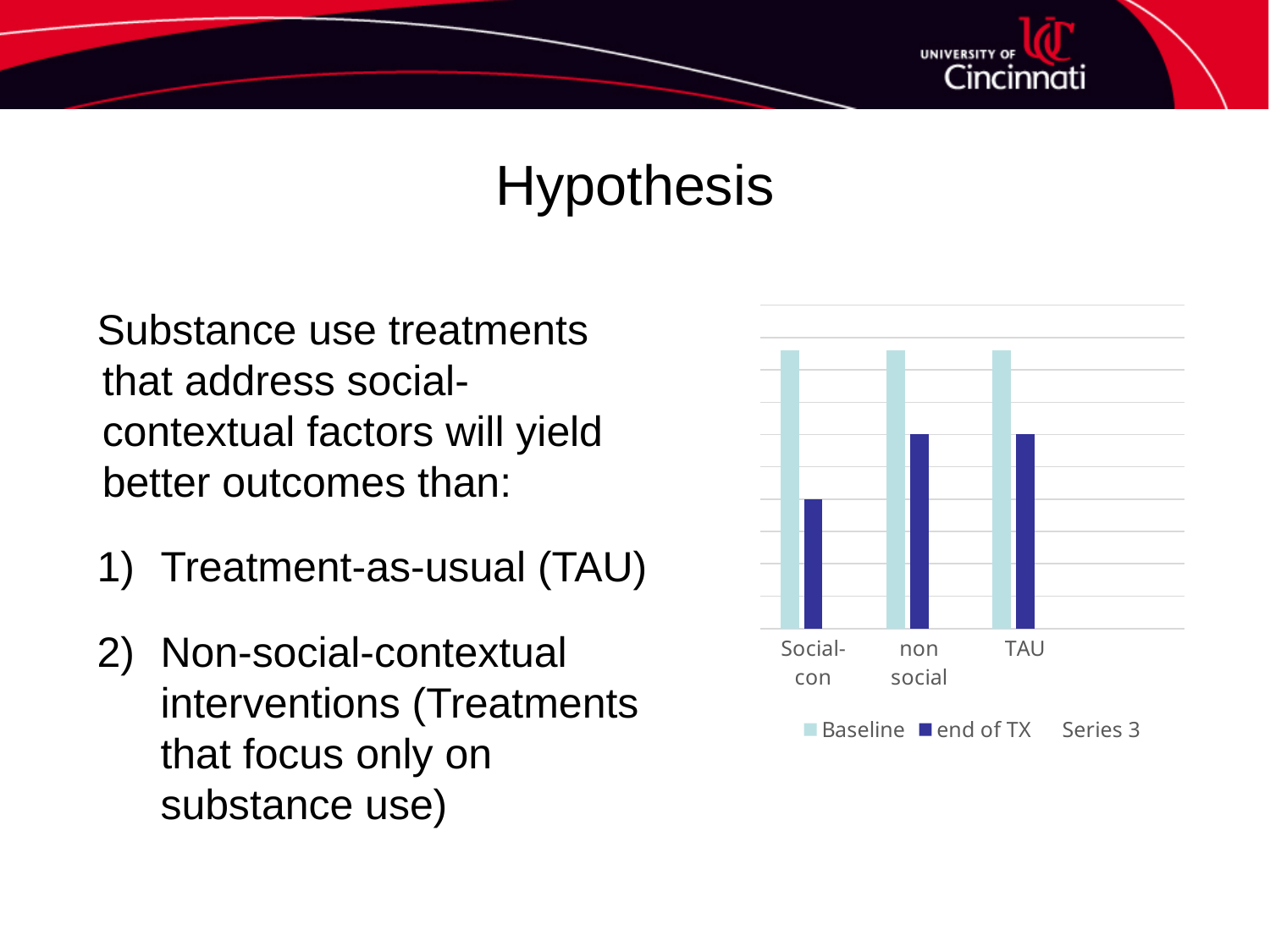
Which category has the lowest end of TX bar? Social-con Which is larger: the end of TX bar for TAU or the end of TX bar for Social-con? TAU How many series does the chart's legend list? 3 Which is larger: the end of TX bar for Social-con or the end of TX bar for non social? non social For Social-con, which is larger: the Baseline bar or the end of TX bar? Baseline What is the label of the third category on the x axis? TAU What colour are the end of TX bars in the chart? dark blue What are the names of the series listed in the chart's legend? Baseline, end of TX, Series 3 What kind of chart is shown on the slide? bar chart How many categories are shown on the x axis of the chart? 3